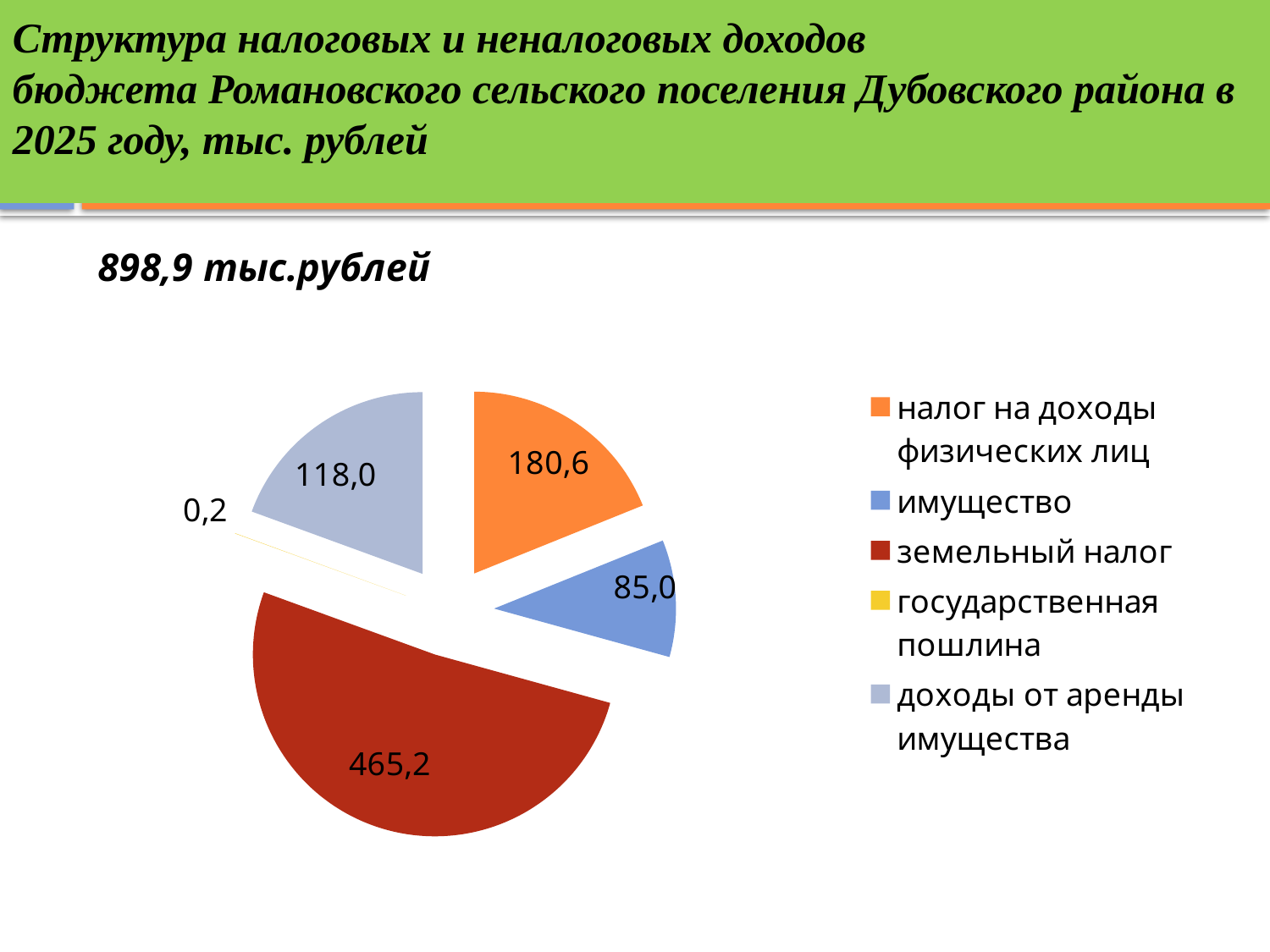
What is the value for "доходы от аренды имущества"? 118,0 Which category has the smallest slice of the pie? государственная пошлина What is the value for "налог на доходы физических лиц"? 180,6 What is the value for "имущество"? 85,0 What is the difference between the values for "земельный налог" and "налог на доходы физических лиц"? 284,6 What is the value for "государственная пошлина"? 0,2 What kind of chart is shown on the slide? Pie chart What is the value for "земельный налог"? 465,2 Which is larger: the value for "налог на доходы физических лиц" or the value for "доходы от аренды имущества"? налог на доходы физических лиц Which category has the largest slice of the pie? земельный налог How many categories does the legend list? 5 What is the difference between the values for "доходы от аренды имущества" and "имущество"? 33,0